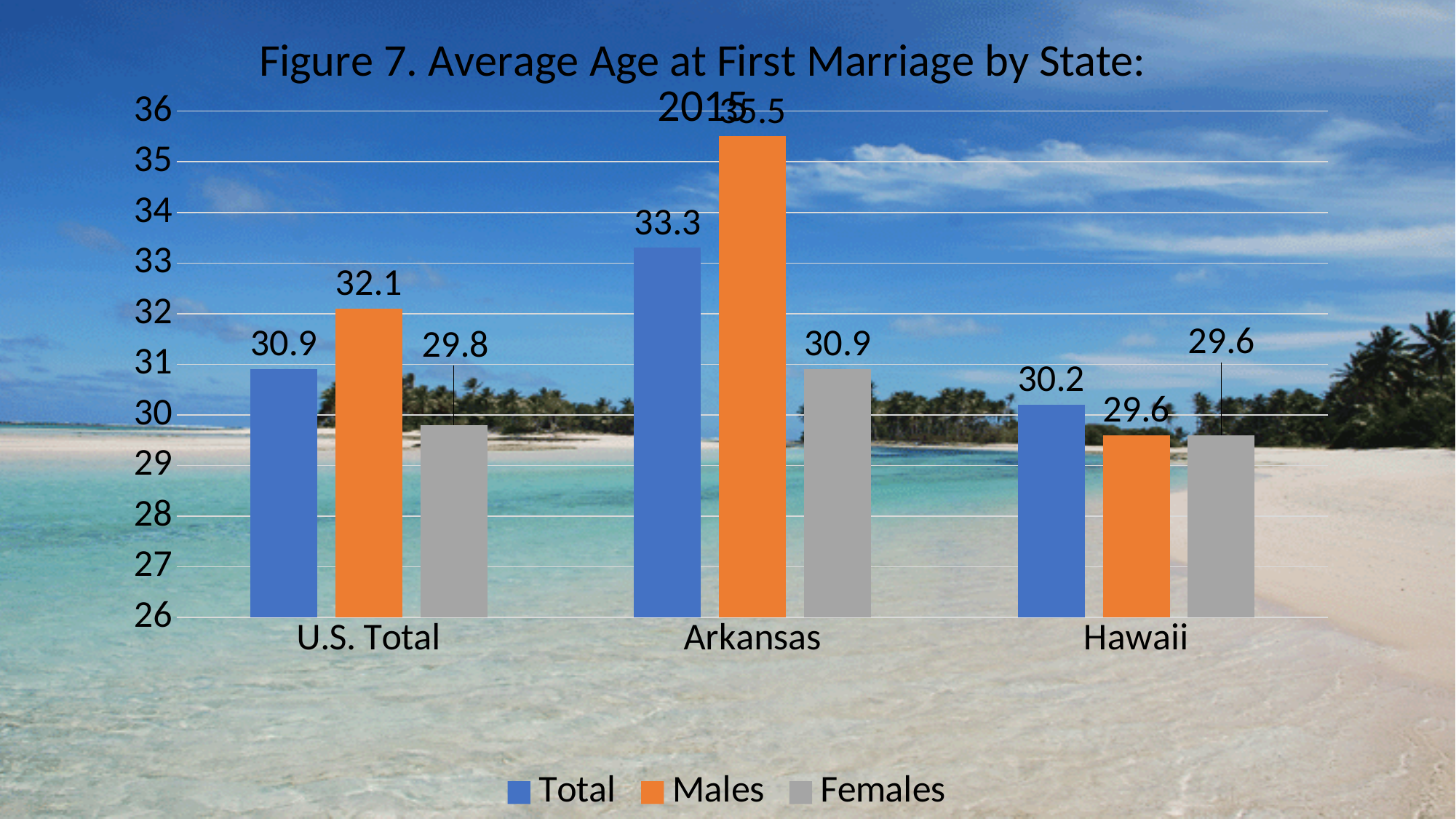
Which state category has the highest Total average age at first marriage? Arkansas How many series does the legend list? 3 How many state categories are shown on the x axis? 3 What kind of chart is shown on the slide? Bar chart What is the Total average age at first marriage for Arkansas? 33.3 Which series is shown in orange in the legend? Males What is the difference between the Total value for Arkansas and the Total value for U.S. Total? 2.4 Which is larger: the Females value for U.S. Total or the Females value for Arkansas? Arkansas What is the average age at first marriage for Males in the U.S. Total category? 32.1 What is the average age at first marriage for Females in Hawaii? 29.6 Which category has the lowest value for Males? Hawaii Is the value for Males in Arkansas greater or less than 35? greater